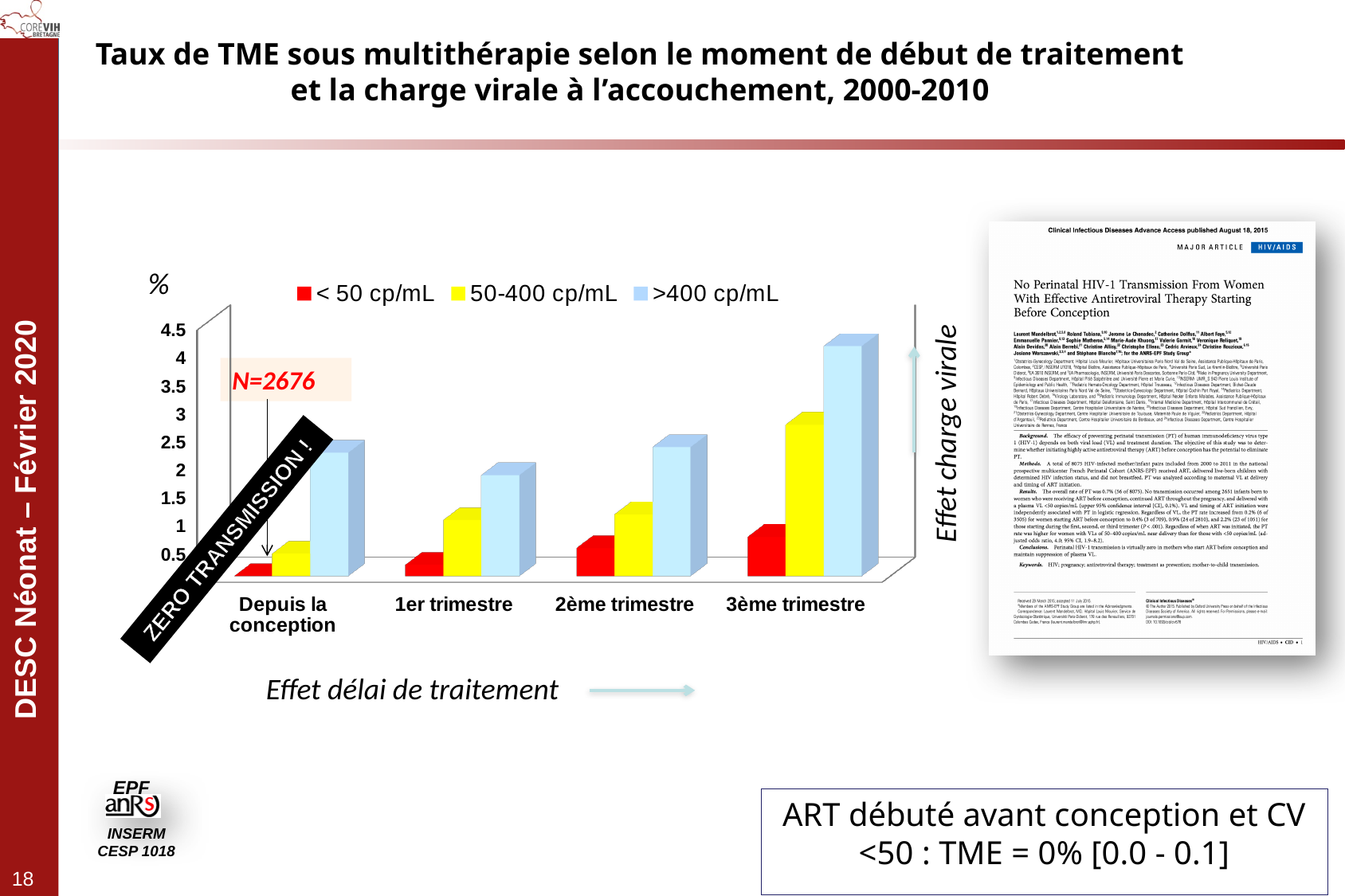
Which category has the shortest bar for the < 50 cp/mL series? Depuis la conception What colour represents the < 50 cp/mL series in the chart legend? red What kind of chart is shown on the slide? bar chart How many treatment-start categories are shown on the x axis of the chart? 4 Is the value for < 50 cp/mL in the Depuis la conception category greater or less than 0.5? less Which is larger: the >400 cp/mL value for 3ème trimestre or the >400 cp/mL value for Depuis la conception? 3ème trimestre Do the values of the < 50 cp/mL series rise or fall from Depuis la conception to 3ème trimestre? rise Which category has the tallest bar for the >400 cp/mL series? 3ème trimestre Within the 3ème trimestre category, which series has the highest value? >400 cp/mL Is the value for >400 cp/mL in the 3ème trimestre category greater or less than 3.5? greater How many series does the chart legend list? 3